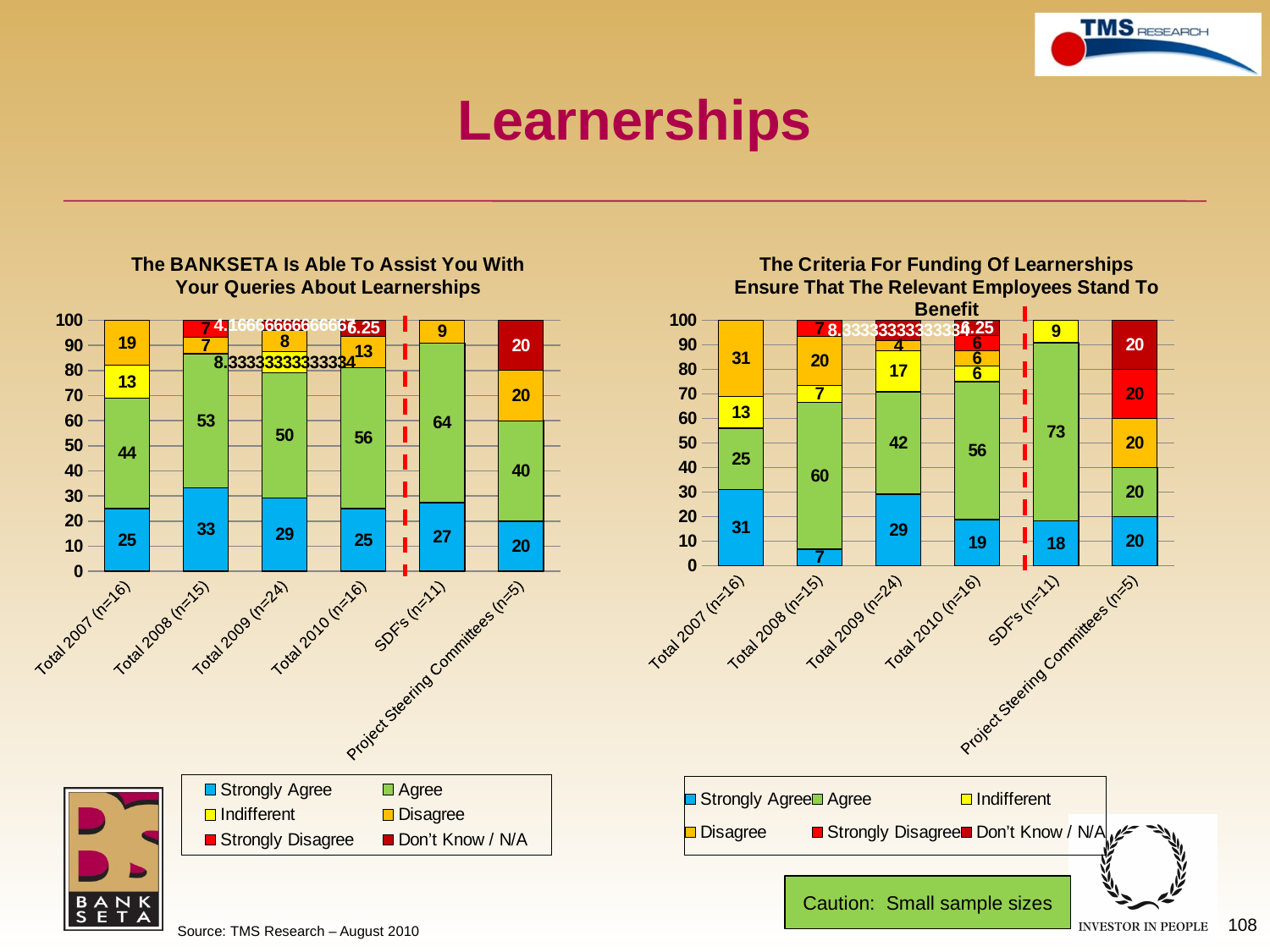
In the chart titled "The BANKSETA Is Able To Assist You With Your Queries About Learnerships", what is the Strongly Agree value for Total 2008 (n=15)? 33 In the right chart, which category has the highest Agree value? SDF's (n=11) How many categories are shown on the x axis of the left chart? 6 In the left chart, what is the difference between the Agree values for Total 2010 (n=16) and Total 2007 (n=16)? 12 In the left chart, which is larger: the Agree value for Total 2008 (n=15) or the Agree value for Total 2009 (n=24)? Total 2008 (n=15) In the chart titled "The Criteria For Funding Of Learnerships Ensure That The Relevant Employees Stand To Benefit", what is the Disagree value for Total 2007 (n=16)? 31 What kind of chart is the left chart? Stacked bar chart In the right chart, which category has the lowest Strongly Agree value? Total 2008 (n=15) In the right chart, what is the Agree value for Total 2008 (n=15)? 60 How many series does the legend of the right chart list? 6 In the left chart, what is the Agree value for SDF's (n=11)? 64 In the left chart, what is the total of the stacked bar for Project Steering Committees (n=5)? 100